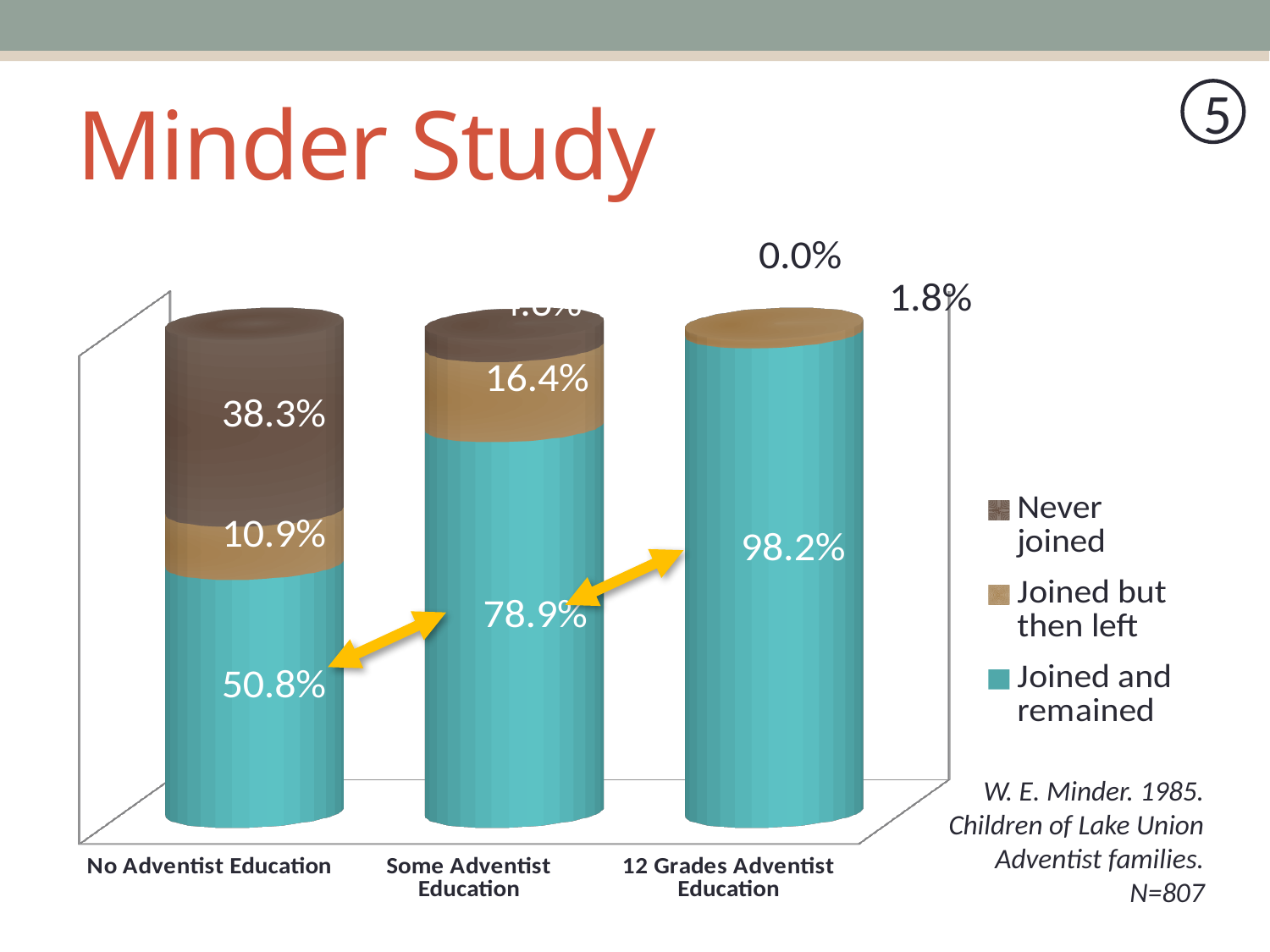
Which category has the highest 'Joined and remained' percentage? 12 Grades Adventist Education How many education categories are shown on the x axis? 3 What is the 'Joined but then left' value for Some Adventist Education? 16.4% How many series does the legend list? 3 What is the 'Joined and remained' value for 12 Grades Adventist Education? 98.2% What percentage of those with No Adventist Education 'Joined and remained'? 50.8% What is the 'Never joined' value for the No Adventist Education category? 38.3% What is the 'Never joined' value for 12 Grades Adventist Education? 0.0% What is the difference between the 'Joined and remained' values for Some Adventist Education and No Adventist Education? 28.1% Which category has the lowest 'Joined but then left' percentage? 12 Grades Adventist Education Is the 'Joined but then left' value larger for No Adventist Education or for Some Adventist Education? Some Adventist Education Does the 'Joined and remained' percentage rise or fall as the amount of Adventist education increases from left to right? rise